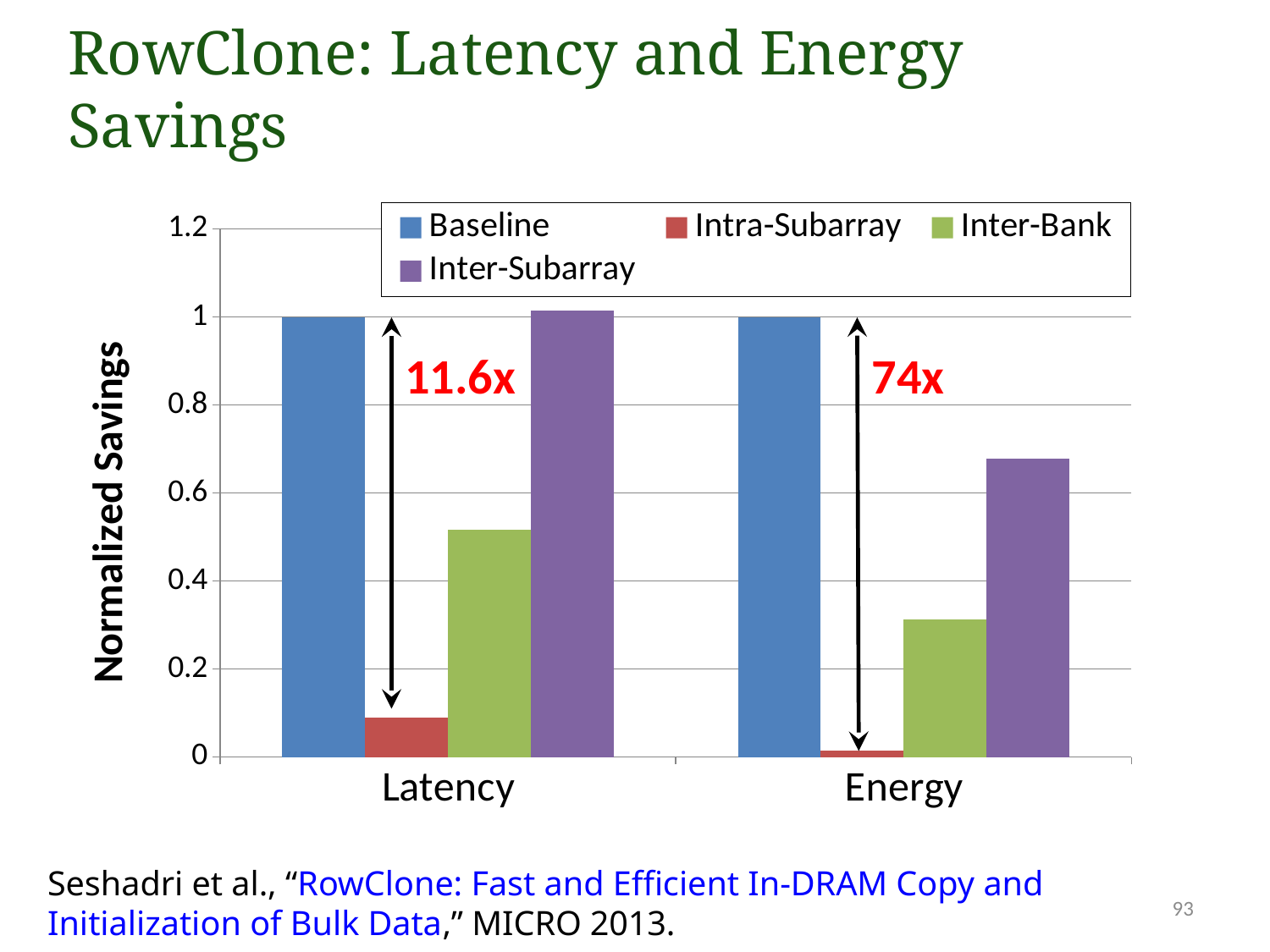
Which series has the lowest value in the Latency category? Intra-Subarray Is the Inter-Bank value for Energy greater or less than 0.4? less Is the Inter-Subarray value for Energy greater or less than 0.6? greater Is the Inter-Bank value for Latency greater or less than 0.4? greater Which series has the lowest value in the Energy category? Intra-Subarray How many categories are shown on the x axis? 2 How many series does the legend list? 4 Which is larger: the Inter-Subarray value for Latency or the Inter-Subarray value for Energy? Latency Which series has the highest value in the Energy category? Baseline What kind of chart is shown on the slide? bar chart What is the Baseline value for Energy? 1 What is the Baseline value for Latency? 1